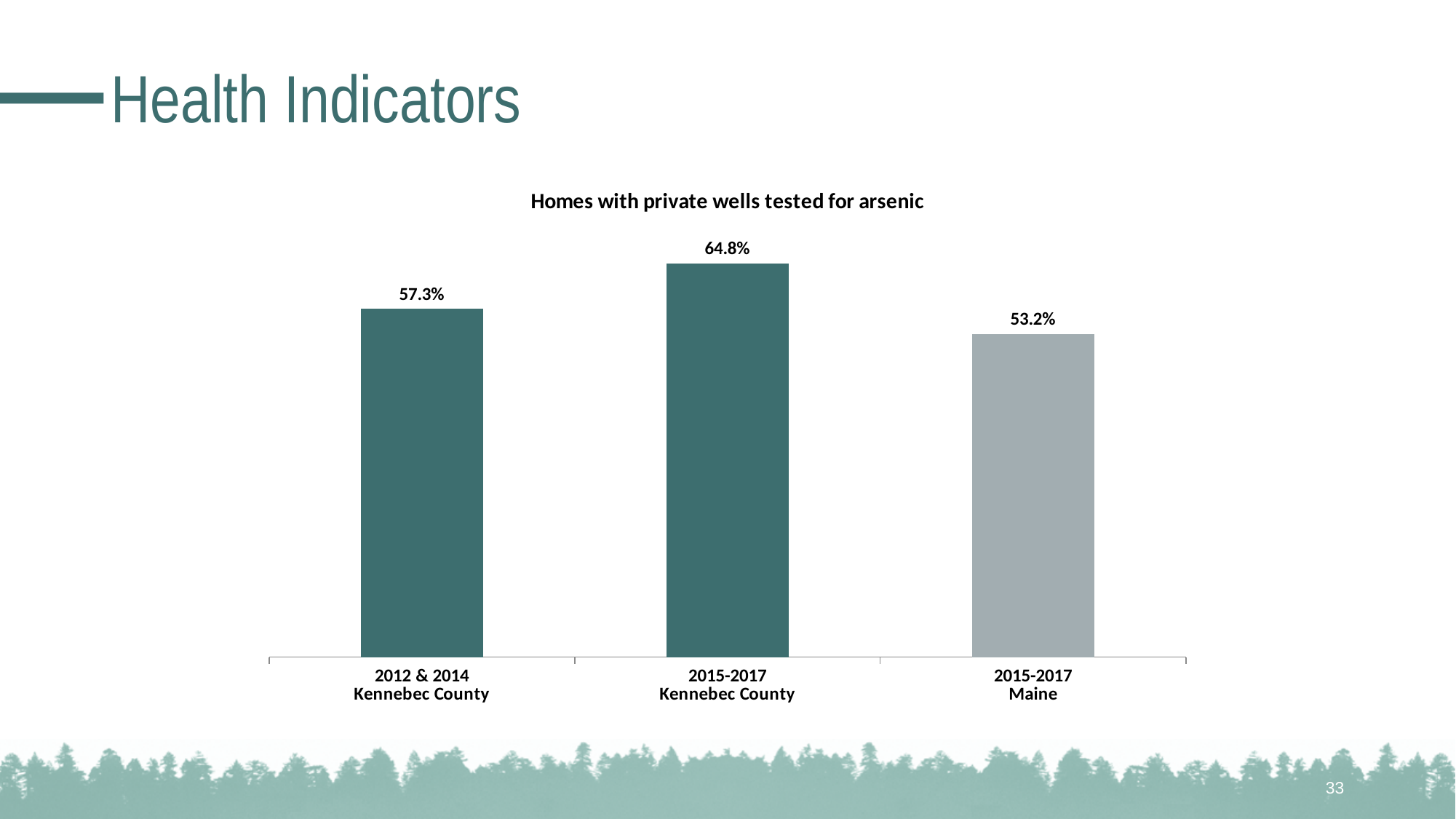
Which category has the highest value? 2015-2017 Kennebec County What is the value for 2015-2017 Kennebec County? 64.8% How many bars are shown in the chart? 3 Which category has the lowest value? 2015-2017 Maine What is the difference between the 2015-2017 Kennebec County value and the 2012 & 2014 Kennebec County value? 7.5% What is the difference between the 2015-2017 Kennebec County value and the 2015-2017 Maine value? 11.6% What is the value for 2012 & 2014 Kennebec County? 57.3% Which bar is coloured grey rather than teal? 2015-2017 Maine What is the title of the chart? Homes with private wells tested for arsenic Which is larger, the value for 2012 & 2014 Kennebec County or the value for 2015-2017 Maine? 2012 & 2014 Kennebec County What kind of chart is shown on the slide? Bar chart What is the value for 2015-2017 Maine? 53.2%